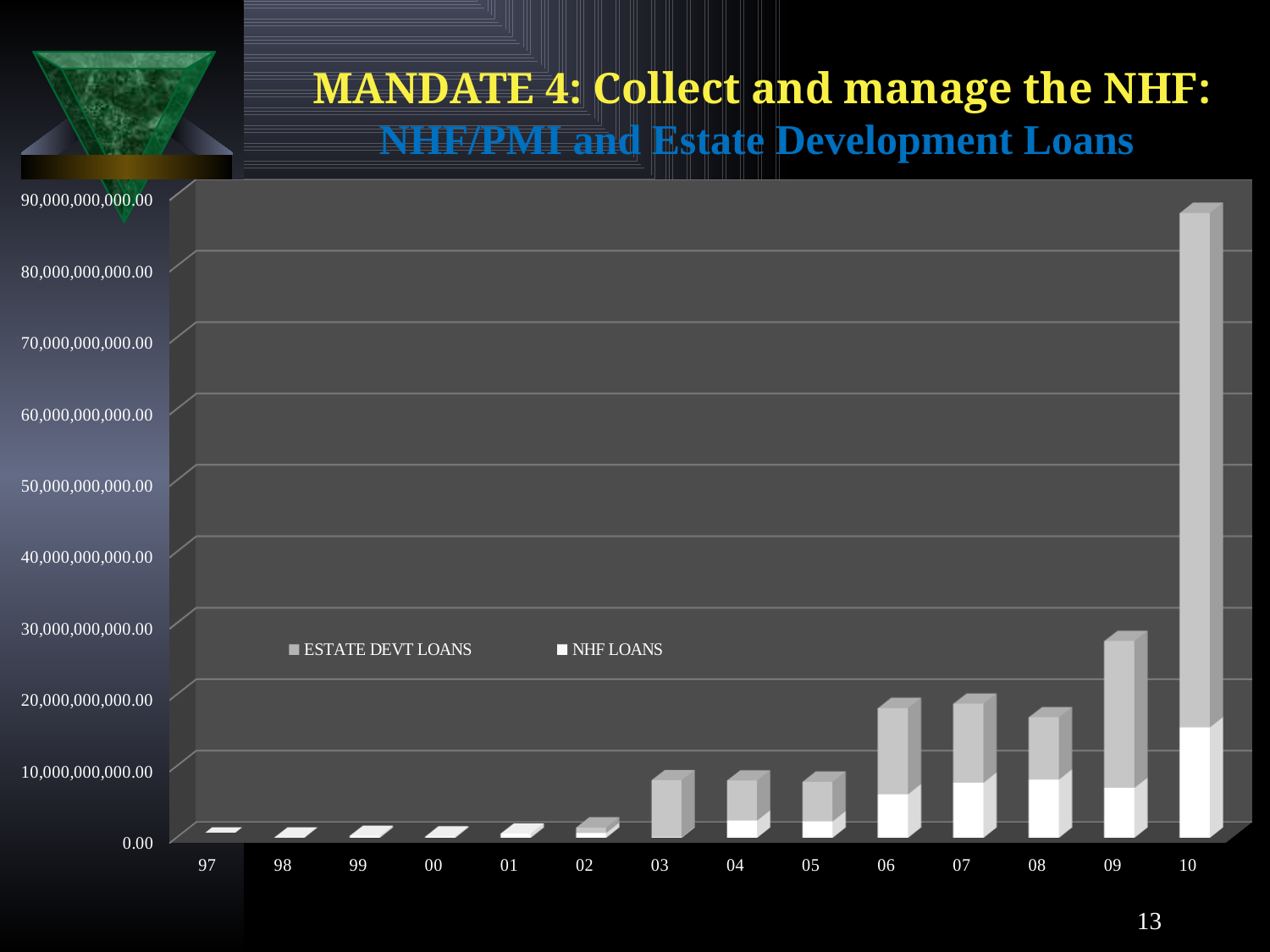
Which year has the larger total bar, 03 or 06? 06 How many series does the chart's legend list? 2 Which year has the larger total bar, 08 or 09? 09 Is the total bar for year 09 greater or less than 30,000,000,000.00? less What are the two series named in the chart's legend? ESTATE DEVT LOANS and NHF LOANS Is the total bar for year 10 greater or less than 80,000,000,000.00? greater Is the total bar for year 03 greater or less than 10,000,000,000.00? less How many years (categories) are shown along the x axis of the chart? 14 Do the total bar values generally rise or fall from 97 to 10? rise Which year has the highest total bar in the chart? 10 What kind of chart is shown on the slide? Stacked bar chart